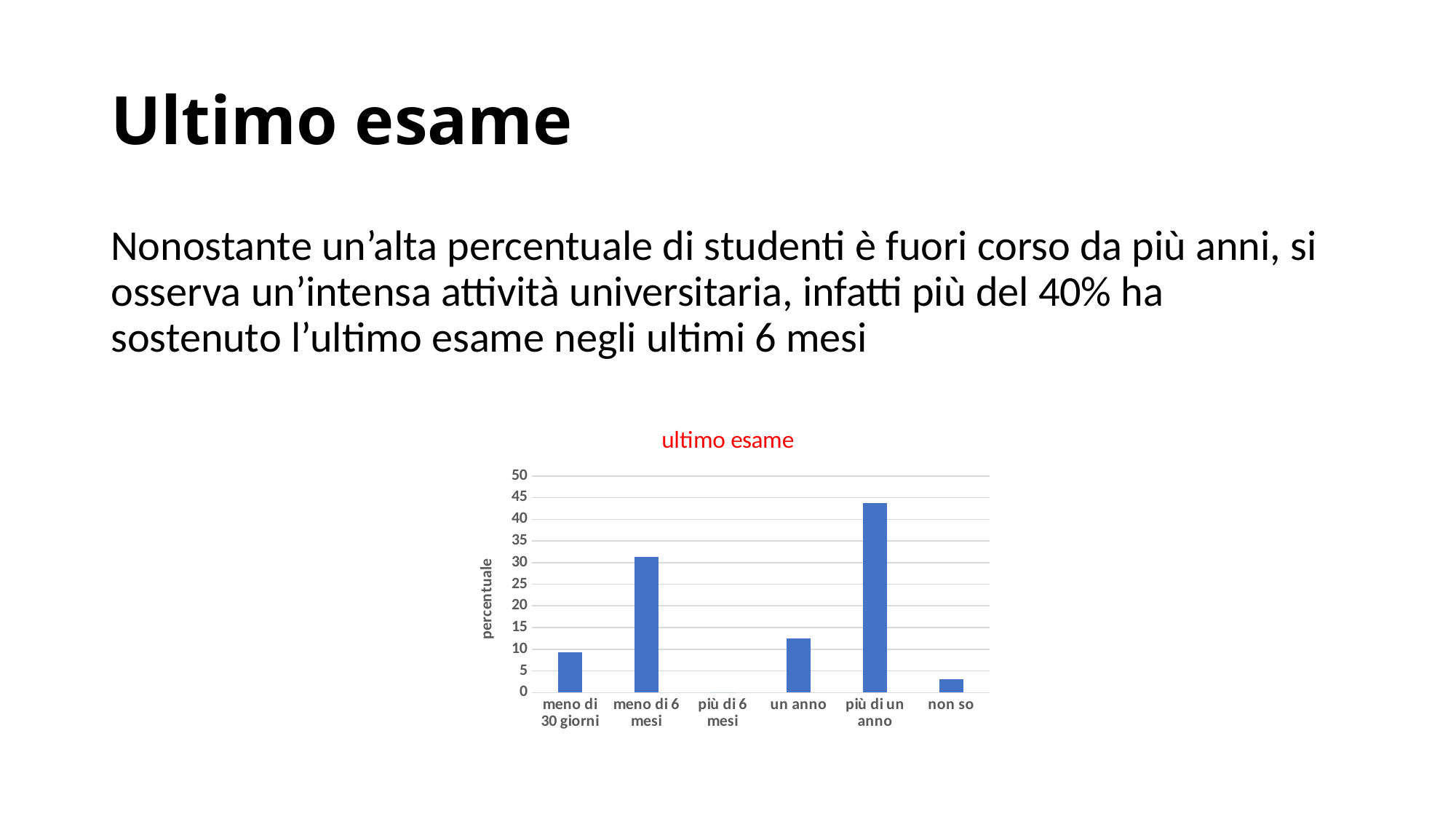
Which is larger, the value for 'meno di 30 giorni' or the value for 'non so'? meno di 30 giorni How many categories are shown on the x axis of the chart? 6 What is the title of the chart? ultimo esame What kind of chart is shown on the slide? bar chart What is the label on the vertical axis of the chart? percentuale Is the value for 'non so' greater or less than 5? less Which is larger, the value for 'meno di 6 mesi' or the value for 'un anno'? meno di 6 mesi Is the value for 'meno di 6 mesi' greater or less than 25? greater Is the value for 'un anno' greater or less than 10? greater Which category has the highest bar in the chart? più di un anno